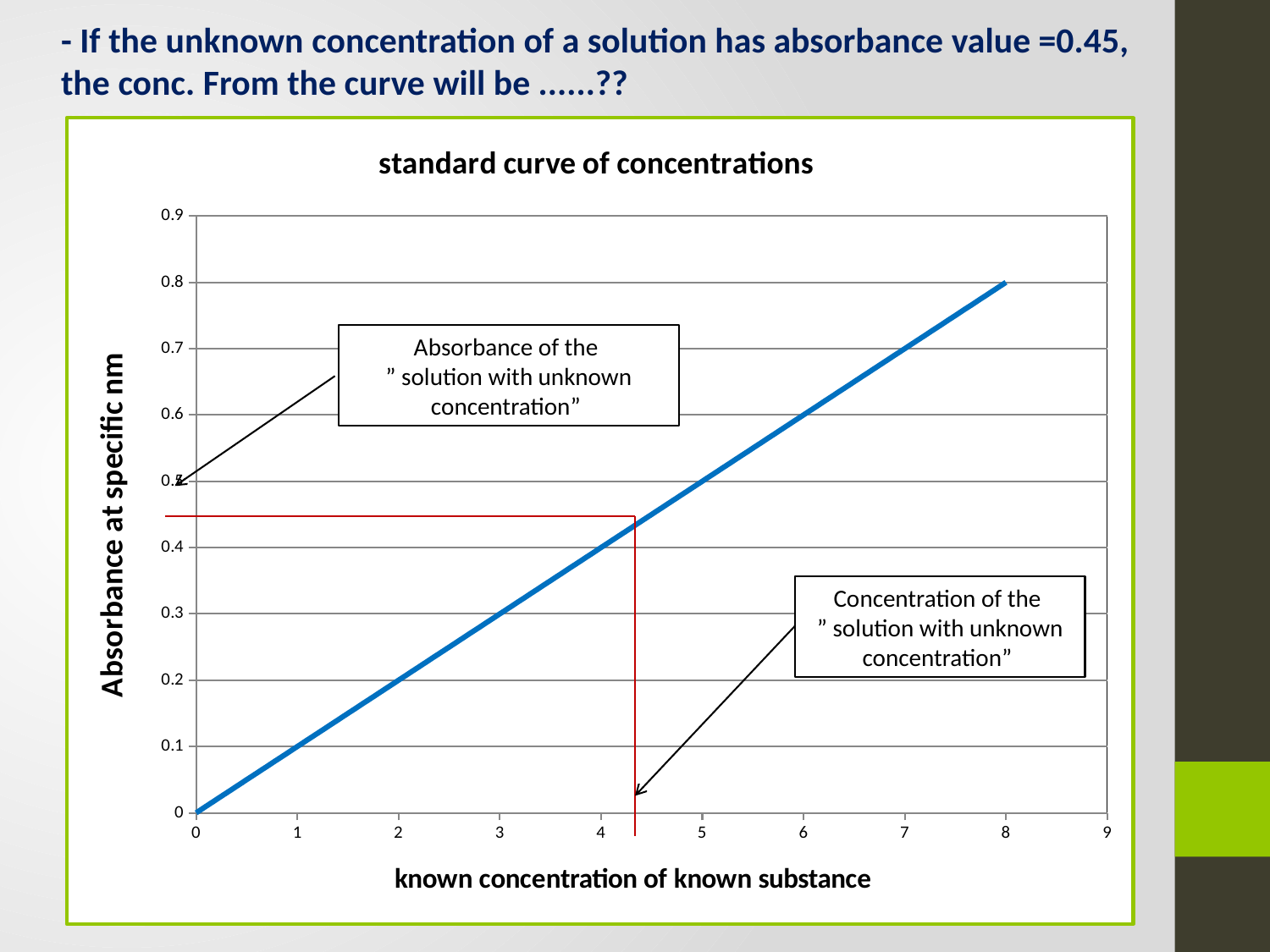
Is the absorbance at a known concentration of 2 greater or less than 0.3? less What is the absorbance value at a known concentration of 0? 0 Is the absorbance at a known concentration of 7 greater or less than 0.6? greater What is the absorbance value at a known concentration of 6? 0.6 What is the absorbance value where the line ends at a known concentration of 8? 0.8 What is the highest value shown on the x axis? 9 Does the absorbance rise or fall as the known concentration increases along the x axis? rise What is the label of the y axis? Absorbance at specific nm Which has the higher absorbance: a known concentration of 3 or a known concentration of 5? 5 What is the absorbance value at a known concentration of 4? 0.4 What kind of chart is shown on the slide? line chart What is the title of the chart? standard curve of concentrations